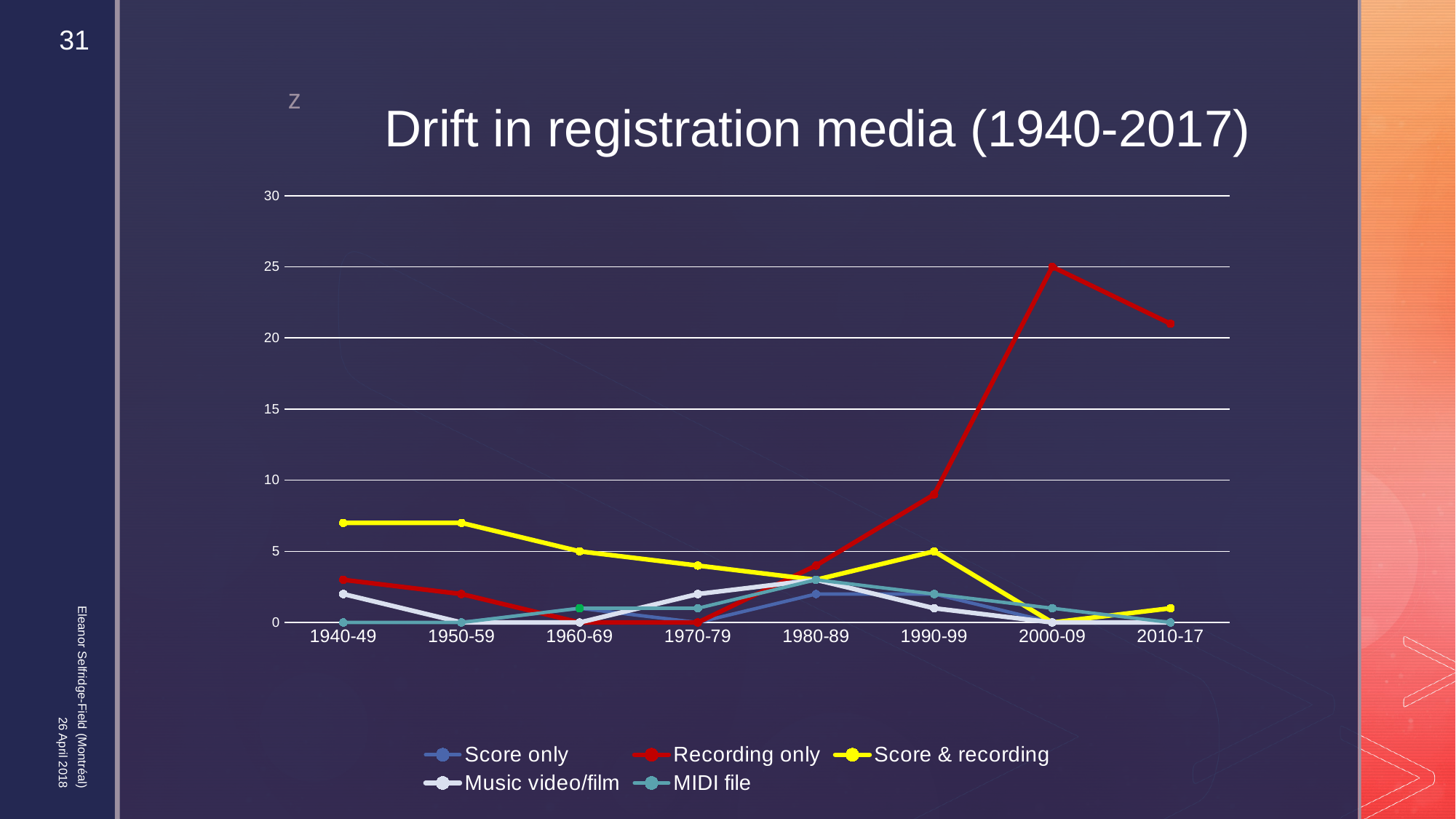
How many time periods are shown on the x axis? 8 Does the Score & recording line rise or fall from 1940-49 to 1970-79? fall Which series reaches the highest value on the chart? Recording only In which period does Recording only reach its highest value? 2000-09 How many series does the legend list? 5 What is the value for Recording only in 1970-79? 0 What is the title of the chart? Drift in registration media (1940-2017) What type of chart is shown on the slide? line chart What is the value for Score & recording in 1990-99? 5 Is the value for Score & recording in 1940-49 greater or less than 5? greater What is the value for Recording only in 2000-09? 25 Is the value for Recording only in 2010-17 greater or less than 15? greater